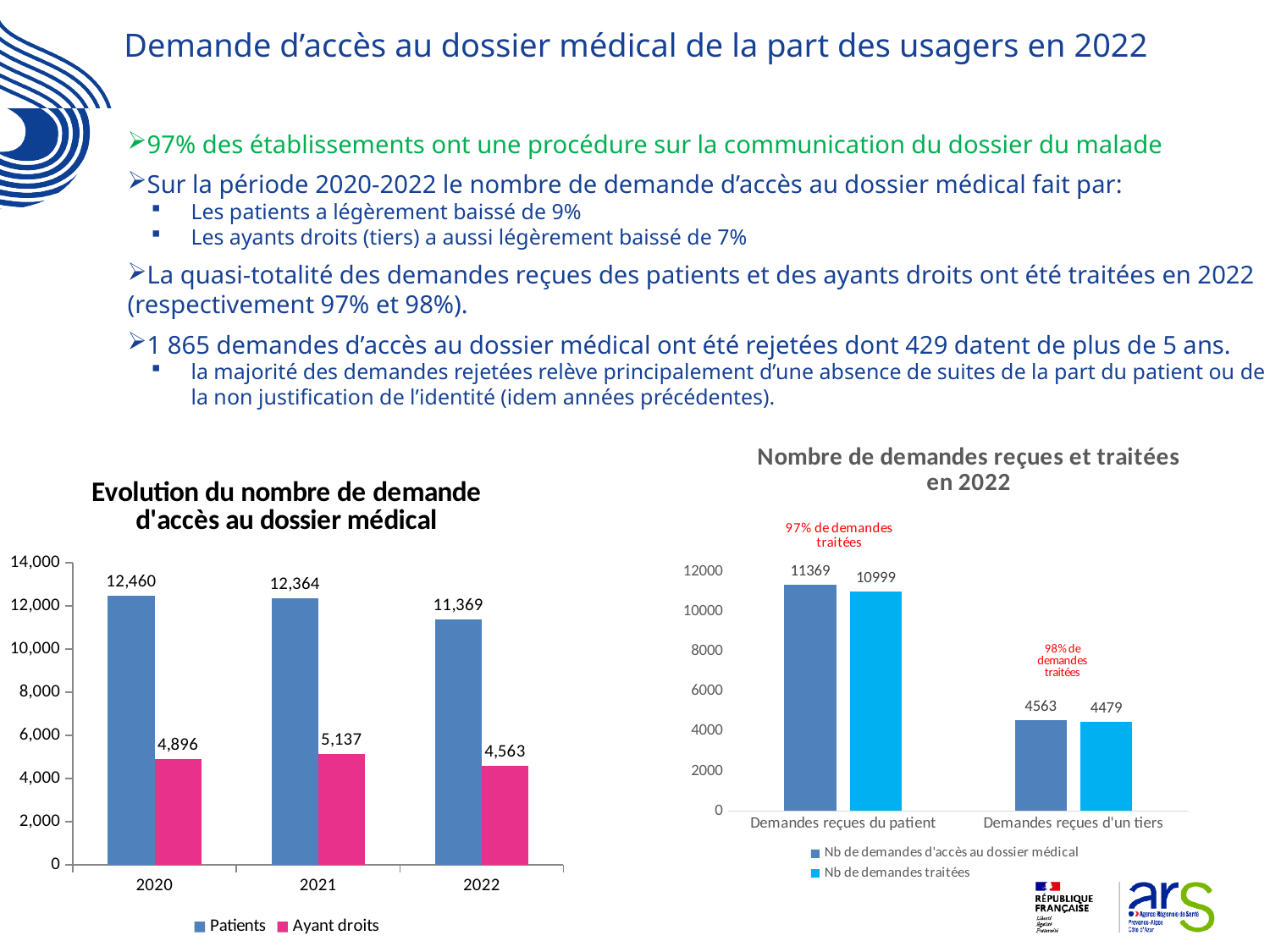
In the chart 'Evolution du nombre de demande d'accès au dossier médical', which year has the highest value for Ayant droits? 2021 In the chart 'Evolution du nombre de demande d'accès au dossier médical', do the Patients values rise or fall from 2020 to 2022? fall In the chart 'Nombre de demandes reçues et traitées en 2022', what is the value of 'Nb de demandes d'accès au dossier médical' for 'Demandes reçues d'un tiers'? 4563 In the chart 'Evolution du nombre de demande d'accès au dossier médical', what is the difference between the Patients values for 2020 and 2022? 1,091 In the chart 'Nombre de demandes reçues et traitées en 2022', which is larger: 'Nb de demandes traitées' for 'Demandes reçues du patient' or for 'Demandes reçues d'un tiers'? Demandes reçues du patient What type of chart is 'Nombre de demandes reçues et traitées en 2022'? bar chart In the chart 'Nombre de demandes reçues et traitées en 2022', what is the value of 'Nb de demandes traitées' for 'Demandes reçues du patient'? 10999 In the chart 'Evolution du nombre de demande d'accès au dossier médical', how many series does the legend list? 2 In the chart 'Evolution du nombre de demande d'accès au dossier médical', what is the value for Ayant droits in 2021? 5,137 In the chart 'Evolution du nombre de demande d'accès au dossier médical', which year has the lowest value for Patients? 2022 In the chart 'Evolution du nombre de demande d'accès au dossier médical', what is the value for Patients in 2020? 12,460 In the chart 'Nombre de demandes reçues et traitées en 2022', what is the difference between the number of requests received and the number treated for 'Demandes reçues d'un tiers'? 84